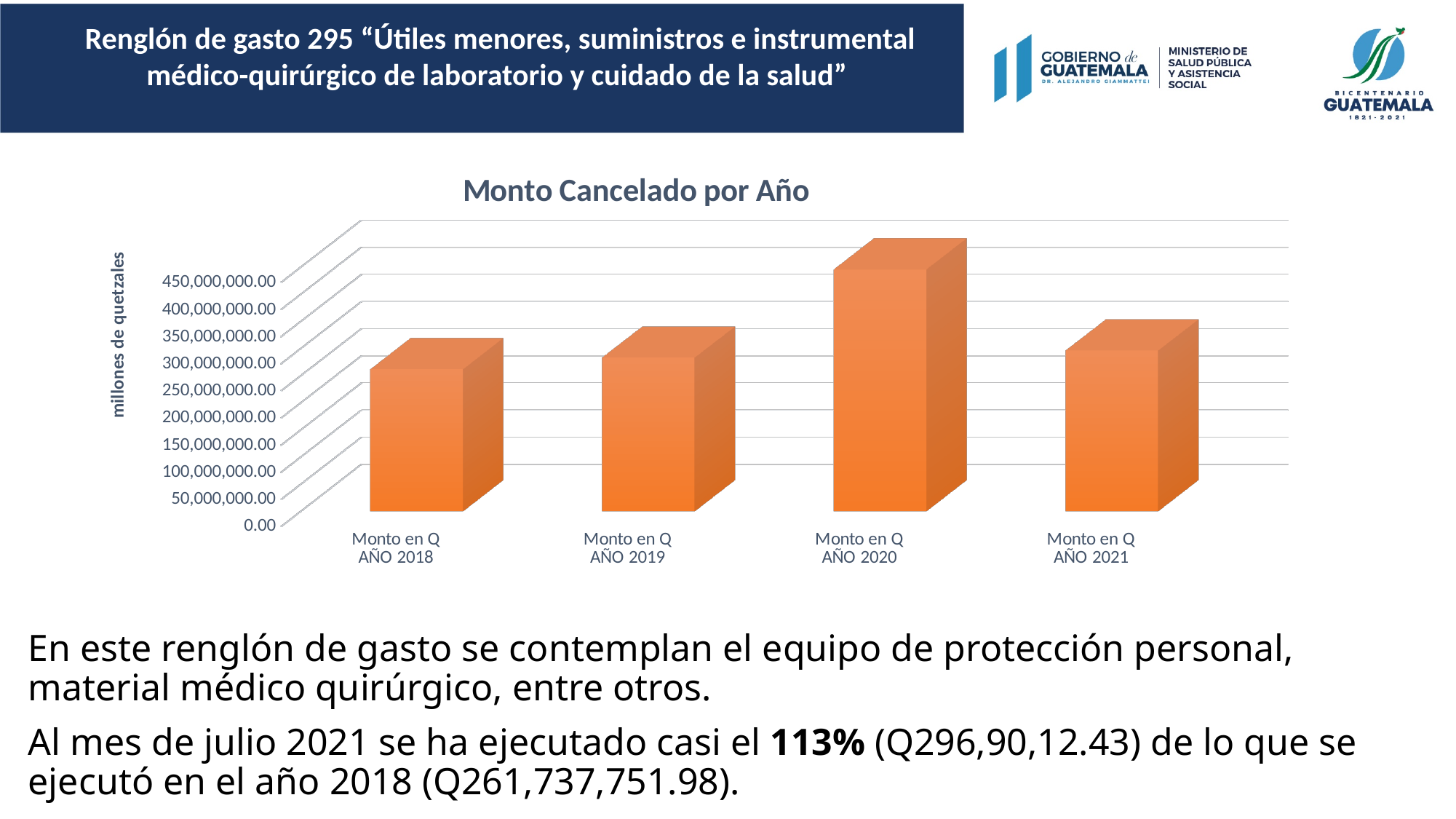
Do the values rise or fall from AÑO 2018 to AÑO 2020? rise How many bars (years) are plotted in the chart? 4 Which is larger, the Monto en Q for AÑO 2019 or for AÑO 2018? AÑO 2019 Which is larger, the Monto en Q for AÑO 2020 or for AÑO 2018? AÑO 2020 What is the label on the vertical axis of the chart? millones de quetzales What is the title of the chart? Monto Cancelado por Año Which year has the lowest Monto en Q? AÑO 2018 Is the value for AÑO 2018 greater or less than 350,000,000.00? less Is the value for AÑO 2021 greater or less than 200,000,000.00? greater Is the value for AÑO 2020 greater or less than 400,000,000.00? greater What kind of chart is shown on the slide? Bar chart Which year has the highest Monto en Q? AÑO 2020